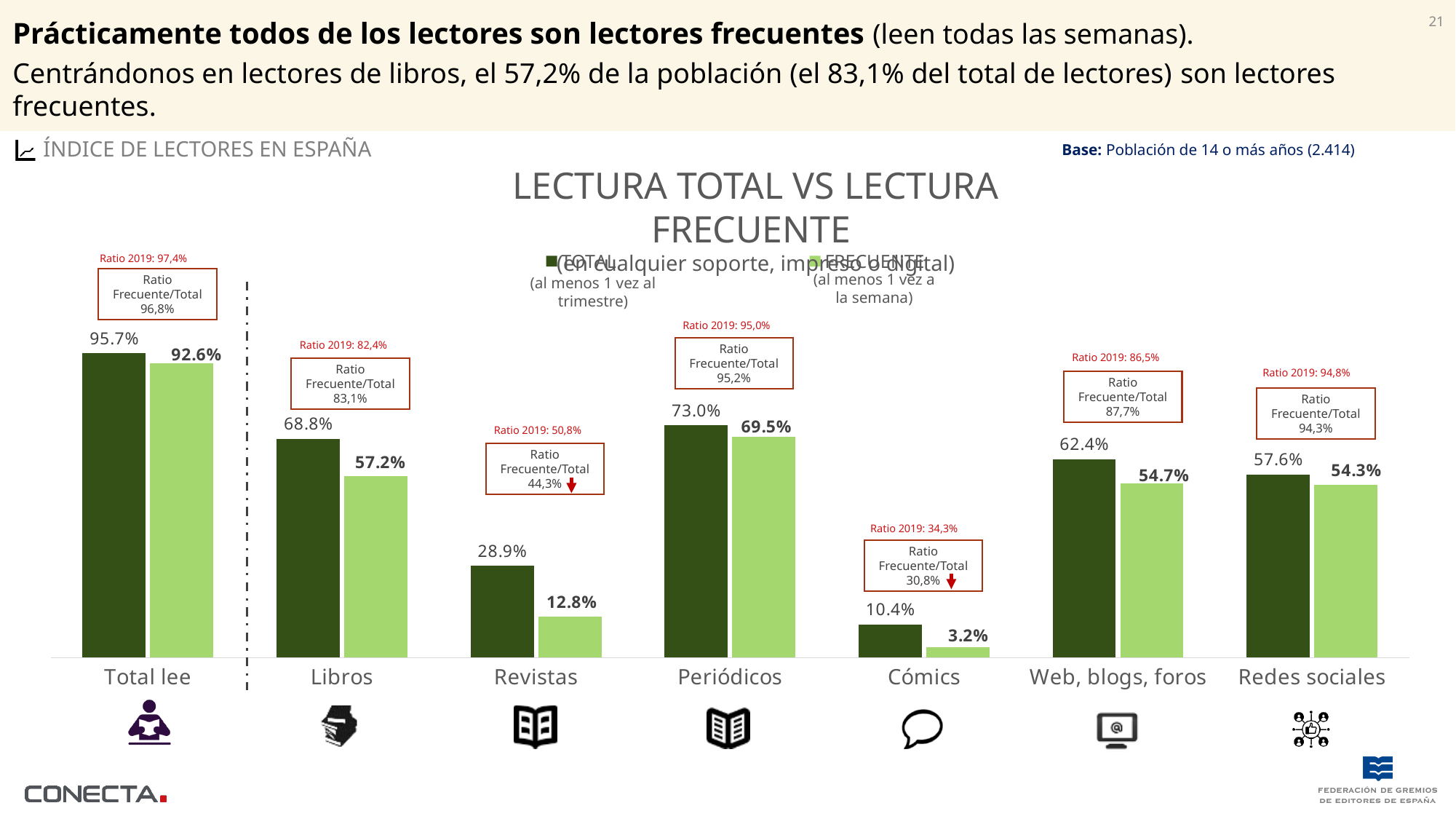
How many categories are shown on the x axis? 7 What is the Ratio Frecuente/Total shown for Periódicos? 95,2% Which category has the highest TOTAL value? Total lee What kind of chart is shown? Bar chart What is the FRECUENTE value for Cómics? 3.2% What is the FRECUENTE value for Periódicos? 69.5% Which category has the lowest FRECUENTE value? Cómics What is the difference between the TOTAL and FRECUENTE values for Revistas? 16.1% Which is larger, the FRECUENTE value for Libros or the FRECUENTE value for Redes sociales? Libros What is the TOTAL value for Libros? 68.8% How many series does the legend list? 2 What is the TOTAL value for Web, blogs, foros? 62.4%